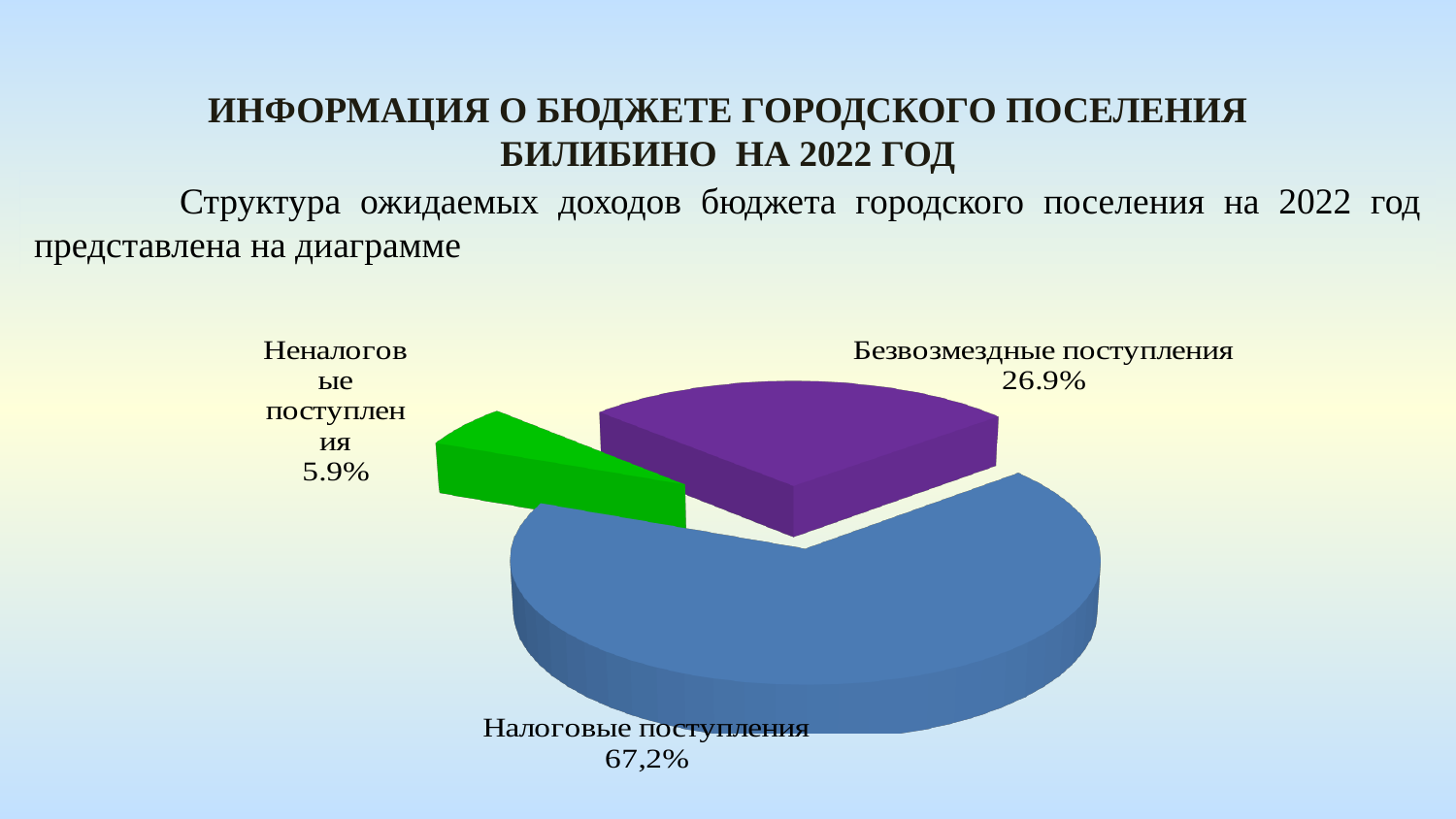
Which category has the largest slice of the pie? Налоговые поступления What colour is the slice for Неналоговые поступления? Green What colour is the slice for Безвозмездные поступления? Purple What is the value shown for Неналоговые поступления? 5.9% How many categories are shown in the pie chart? 3 Which is larger, Безвозмездные поступления or Неналоговые поступления? Безвозмездные поступления What is the difference between the shares of Безвозмездные поступления and Неналоговые поступления? 21.0% What share of the pie does Налоговые поступления represent? 67,2% What is the value shown for Безвозмездные поступления? 26.9% What kind of chart is shown on the slide? Pie chart Which category has the smallest slice of the pie? Неналоговые поступления